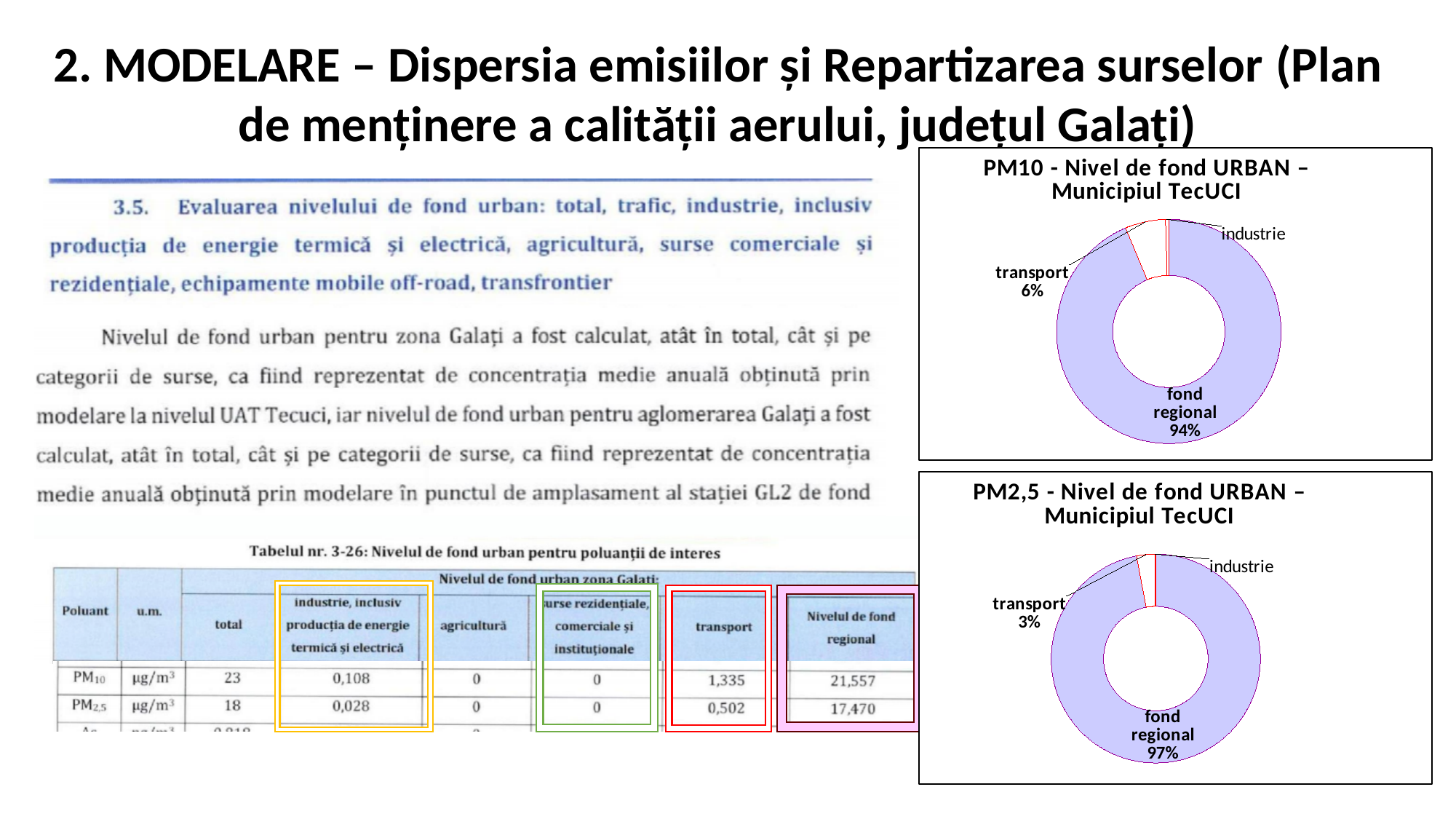
In the PM10 - Nivel de fond URBAN – Municipiul Tecuci chart, which category has the largest share? fond regional In the PM2,5 - Nivel de fond URBAN – Municipiul Tecuci chart, what share does transport have? 3% Which chart shows a larger share for transport, the PM10 chart or the PM2,5 chart? PM10 In the PM10 - Nivel de fond URBAN – Municipiul Tecuci chart, what share does fond regional have? 94% How many categories are shown in the PM10 - Nivel de fond URBAN – Municipiul Tecuci chart? 3 In the PM2,5 - Nivel de fond URBAN – Municipiul Tecuci chart, which is larger, the transport share or the industrie share? transport What type of chart is the PM2,5 - Nivel de fond URBAN – Municipiul Tecuci chart? Doughnut chart In the PM10 - Nivel de fond URBAN – Municipiul Tecuci chart, what is the difference between the fond regional share and the transport share? 88% In the PM2,5 - Nivel de fond URBAN – Municipiul Tecuci chart, what share does fond regional have? 97% In the PM2,5 - Nivel de fond URBAN – Municipiul Tecuci chart, which category has the smallest share? industrie In the PM10 - Nivel de fond URBAN – Municipiul Tecuci chart, what share does transport have? 6% What is the title of the upper chart on the right side of the slide? PM10 - Nivel de fond URBAN – Municipiul TecUCI